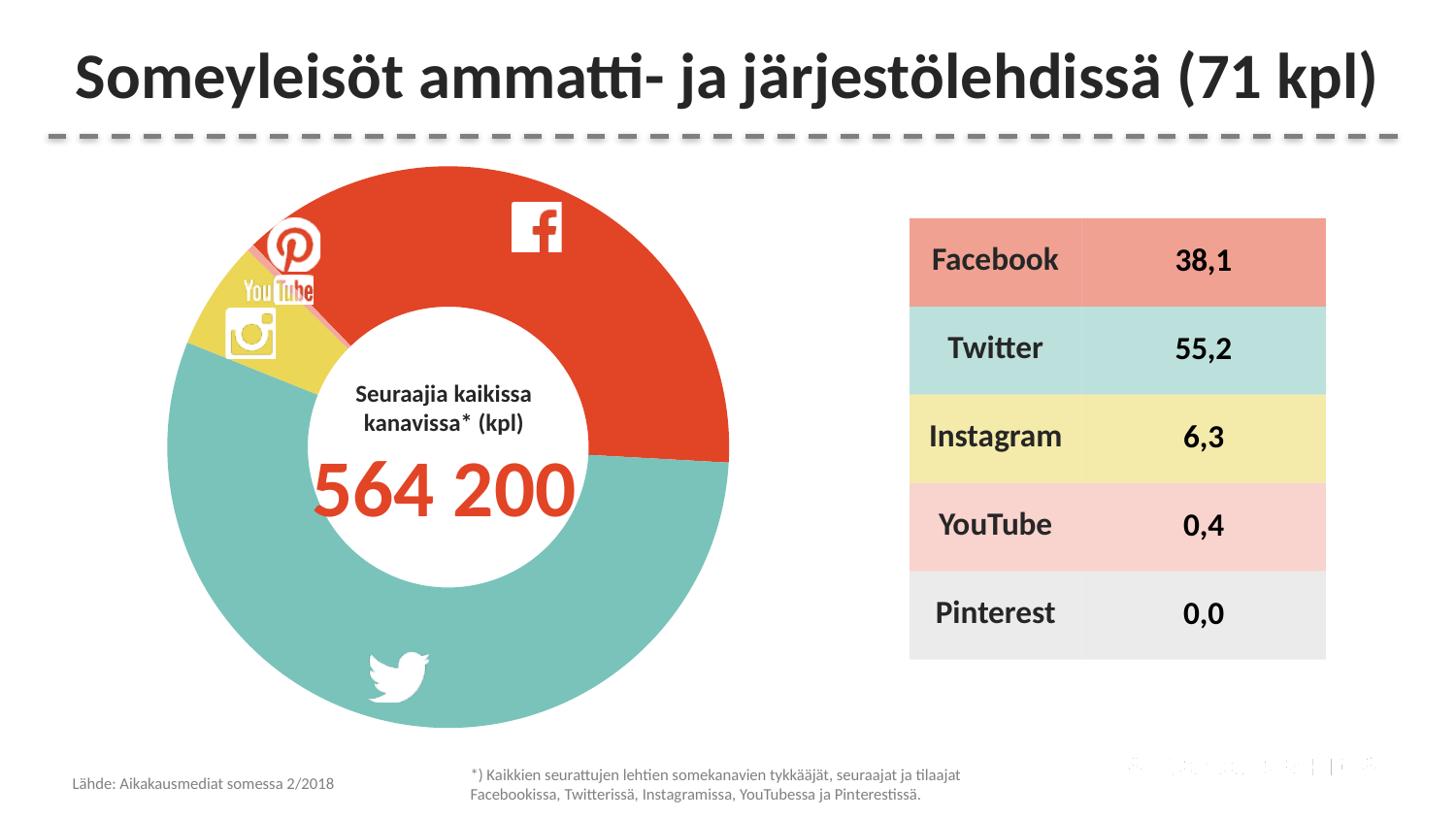
What is the value for Twitter? 55,2 How many channels are listed in the table next to the chart? 5 What total number of followers across all channels is shown in the centre of the chart? 564 200 What kind of chart is shown on the slide? pie chart (donut) What is the value for Facebook? 38,1 What is the difference between the Twitter and Facebook values? 17,1 What is the value for YouTube? 0,4 Which channel has the largest share of the chart? Twitter Which channel has the smallest value? Pinterest What is the title of the slide? Someyleisöt ammatti- ja järjestölehdissä (71 kpl) Which is larger, the value for Facebook or the value for Instagram? Facebook What is the value for Instagram? 6,3